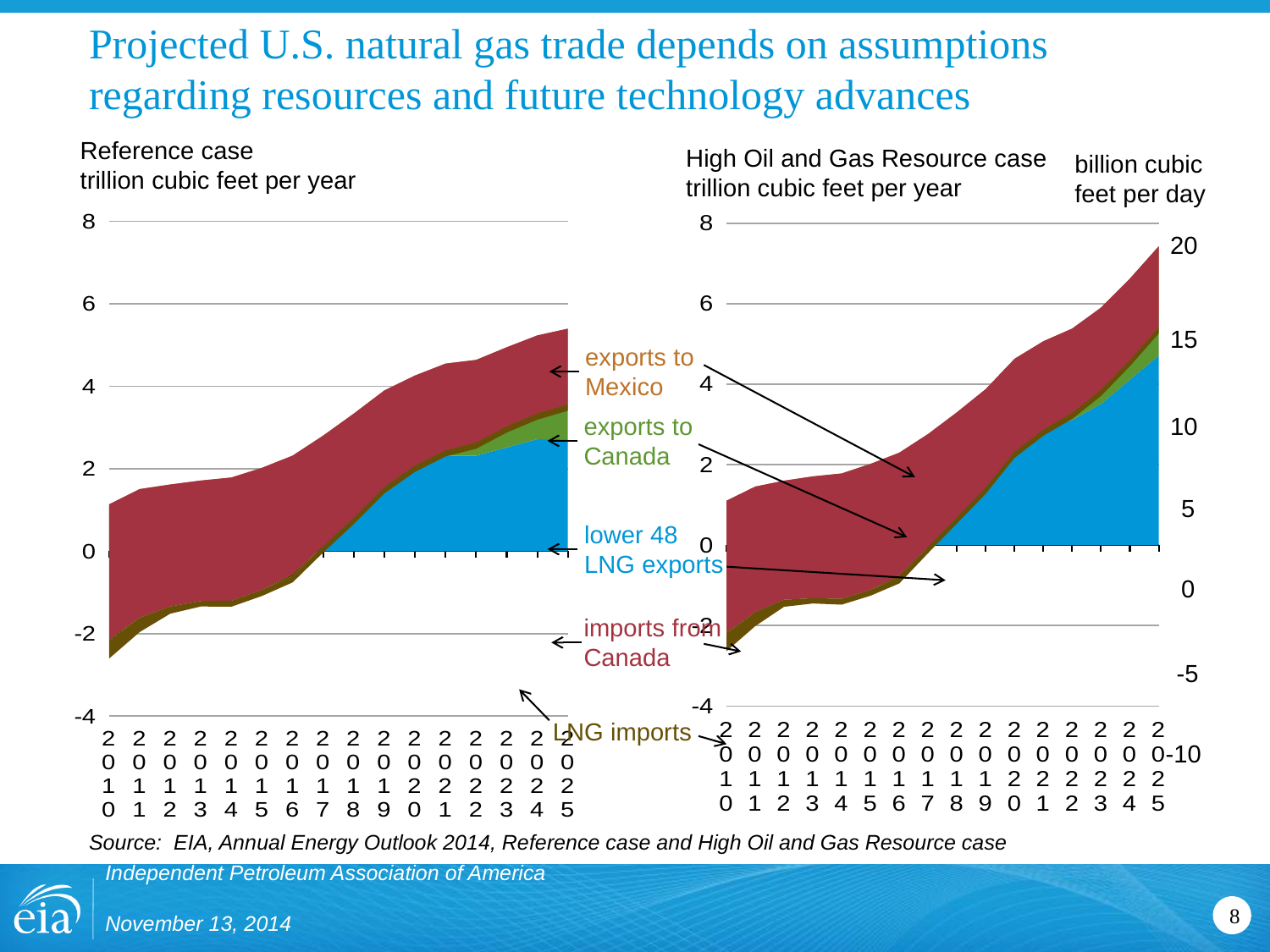
How many years are shown on the x axis of the Reference case chart? 16 In the Reference case chart, is the top of the stacked exports in 2025 greater or less than 4? greater In the Reference case chart, is the bottom of the stacked imports in 2010 greater or less than -2? less Which chart shows higher total exports in 2025, the Reference case or the High Oil and Gas Resource case? High Oil and Gas Resource case How many series are labeled on the slide for the charts? 5 What kind of chart is the Reference case chart? stacked area chart In the Reference case chart, is the lower 48 LNG exports value in 2025 greater or less than 2? greater What unit is shown on the right-hand axis of the High Oil and Gas Resource case chart? billion cubic feet per day In the Reference case chart, do lower 48 LNG exports rise or fall from 2010 to 2025? rise What unit is used on the left axis of the Reference case chart? trillion cubic feet per year